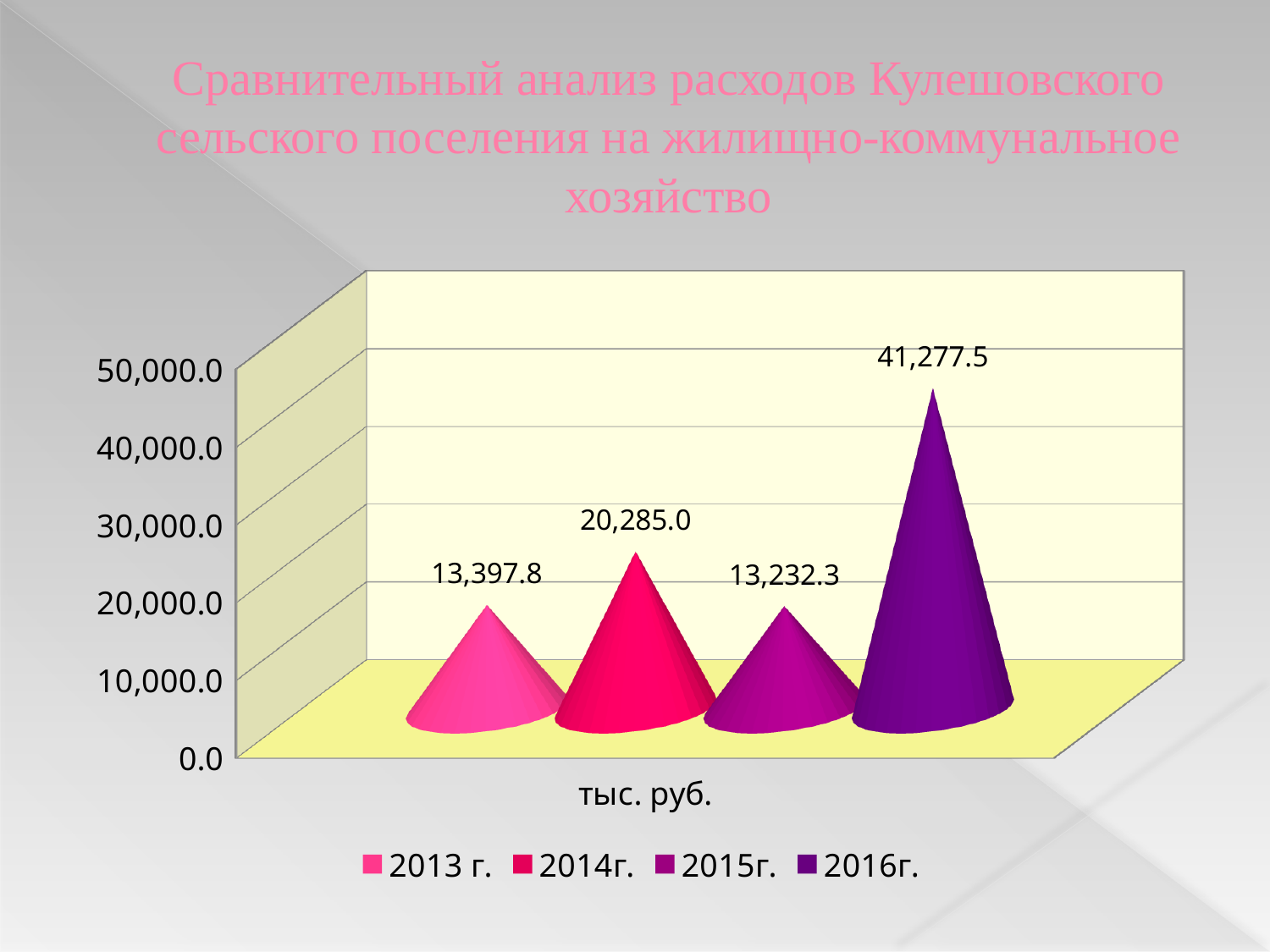
How many series does the legend list? 4 What unit is shown on the horizontal axis label? тыс. руб. What is the difference between the values for 2016г. and 2014г.? 20,992.5 Which is larger, the value for 2014г. or the value for 2015г.? 2014г. What is the value for 2013 г.? 13,397.8 Which year has the highest value? 2016г. What is the value for 2014г.? 20,285.0 Is the value for 2016г. greater or less than 40,000.0? greater Which year has the lowest value? 2015г. What is the value for 2015г.? 13,232.3 What is the value for 2016г.? 41,277.5 What is the difference between the values for 2014г. and 2013 г.? 6,887.2